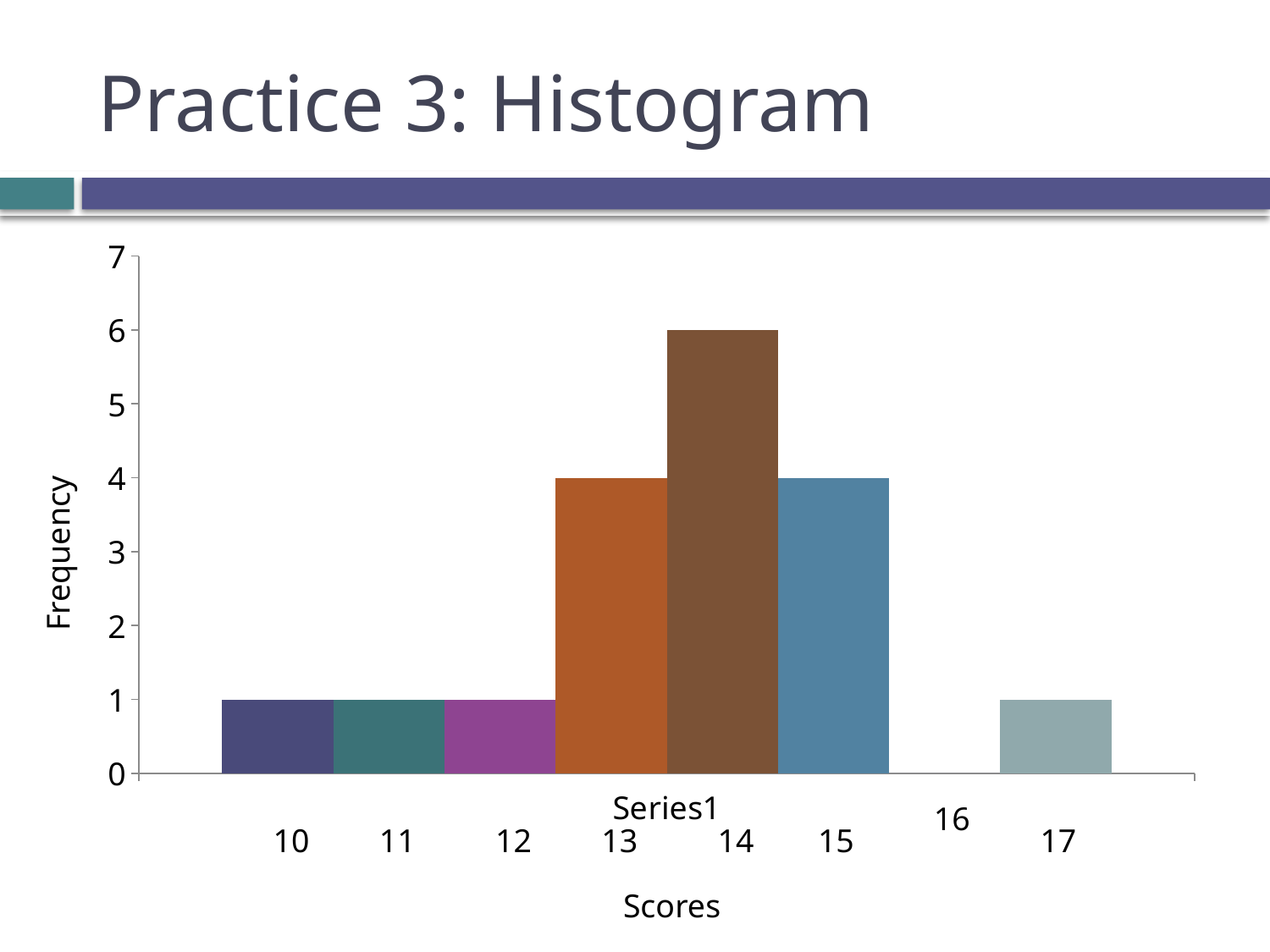
What kind of chart is shown on the slide? Bar chart (histogram) Which score has the highest frequency? 14 Which score has the lowest frequency? 16 What is the label of the vertical axis? Frequency What is the label of the horizontal axis? Scores What is the frequency for a score of 14? 6 How many score categories are shown on the x axis? 8 Which has a higher frequency, a score of 13 or a score of 12? 13 What is the difference between the frequency for a score of 14 and the frequency for a score of 15? 2 What is the frequency for a score of 13? 4 What is the frequency for a score of 17? 1 What is the frequency for a score of 16? 0